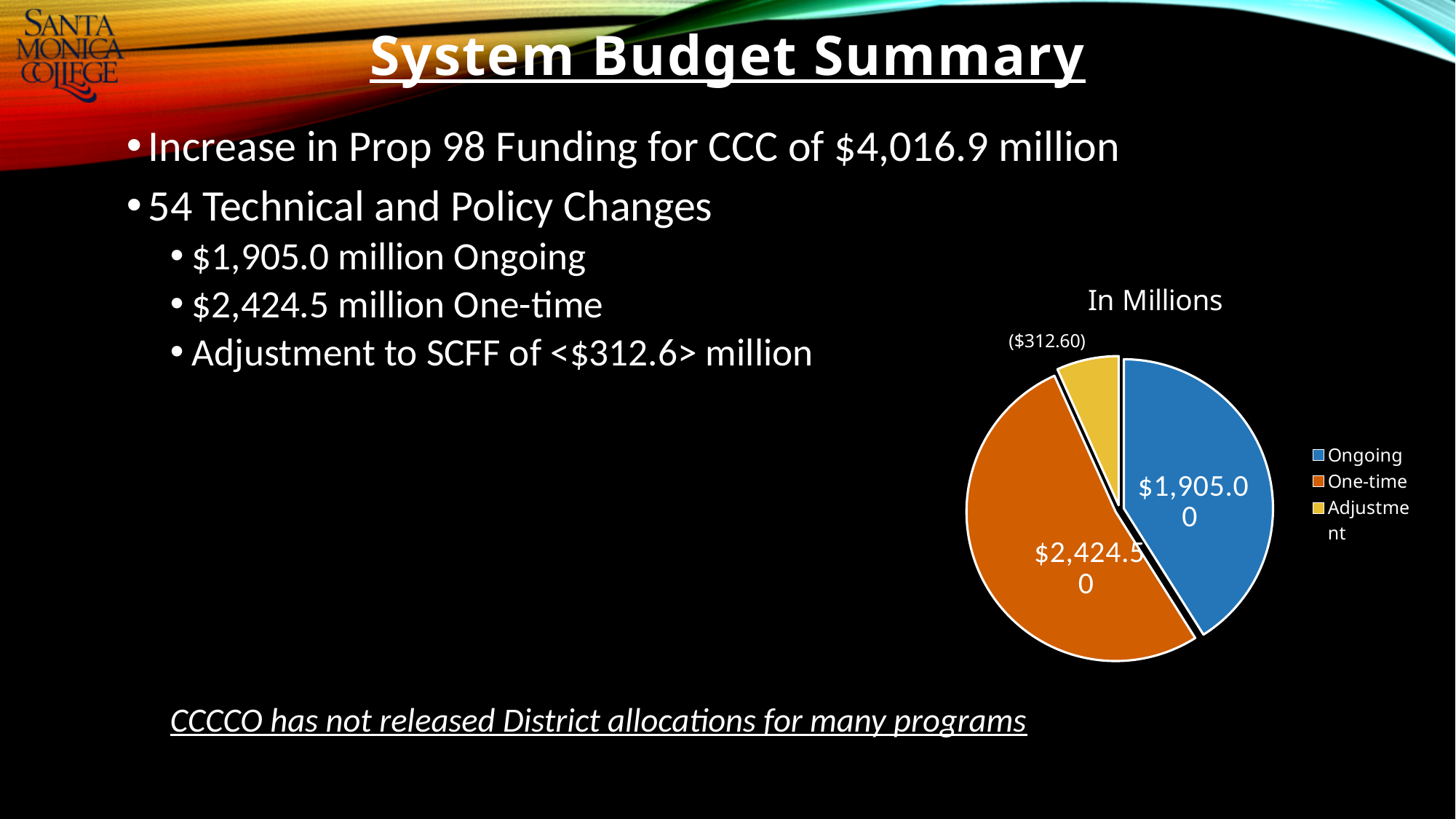
What value is shown for the Ongoing slice of the pie chart? $1,905.00 What is the difference between the One-time value and the Ongoing value in the pie chart? $519.50 How many slices does the pie chart have? 3 What value is shown for the One-time slice of the pie chart? $2,424.50 What type of chart is shown on the slide? Pie chart What is the title of the pie chart? In Millions Which is larger in the pie chart, Ongoing or One-time? One-time Which category has the smallest slice in the pie chart? Adjustment What colour is the One-time slice in the pie chart? Orange What value is shown for the Adjustment slice of the pie chart? ($312.60) How many entries does the pie chart's legend list? 3 Which category has the largest slice in the pie chart? One-time